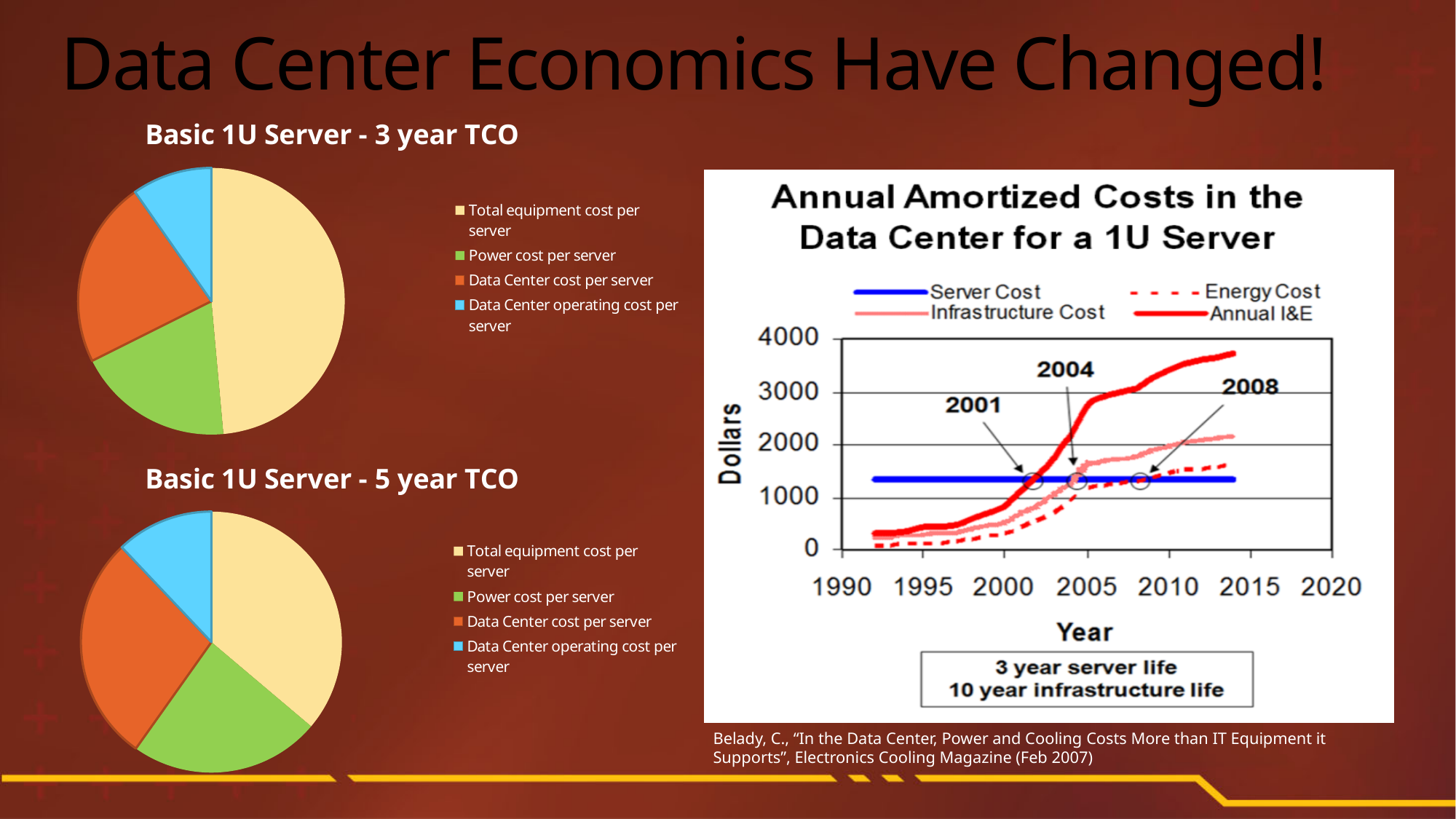
In the 'Annual Amortized Costs in the Data Center for a 1U Server' chart, is the Server Cost line greater or less than 2000 dollars? less In the 'Basic 1U Server - 5 year TCO' pie chart, which slice is larger: Total equipment cost per server or Power cost per server? Total equipment cost per server In the 'Basic 1U Server - 3 year TCO' pie chart, which category has the smallest slice? Data Center operating cost per server In the 'Basic 1U Server - 3 year TCO' pie chart, which category has the largest slice? Total equipment cost per server What kind of chart is 'Annual Amortized Costs in the Data Center for a 1U Server'? Line chart In the 'Annual Amortized Costs in the Data Center for a 1U Server' chart, does the Annual I&E series rise or fall over the years? Rise In the 'Basic 1U Server - 5 year TCO' pie chart, which category has the largest slice? Total equipment cost per server How many categories does the legend of the 'Basic 1U Server - 3 year TCO' chart list? 4 In the 'Basic 1U Server - 5 year TCO' pie chart, which category has the smallest slice? Data Center operating cost per server How many series does the legend of the 'Annual Amortized Costs in the Data Center for a 1U Server' chart list? 4 In the 'Annual Amortized Costs in the Data Center for a 1U Server' chart, is the Annual I&E value at the end of the series (around 2014) greater or less than 3000 dollars? greater What kind of chart is 'Basic 1U Server - 5 year TCO'? Pie chart